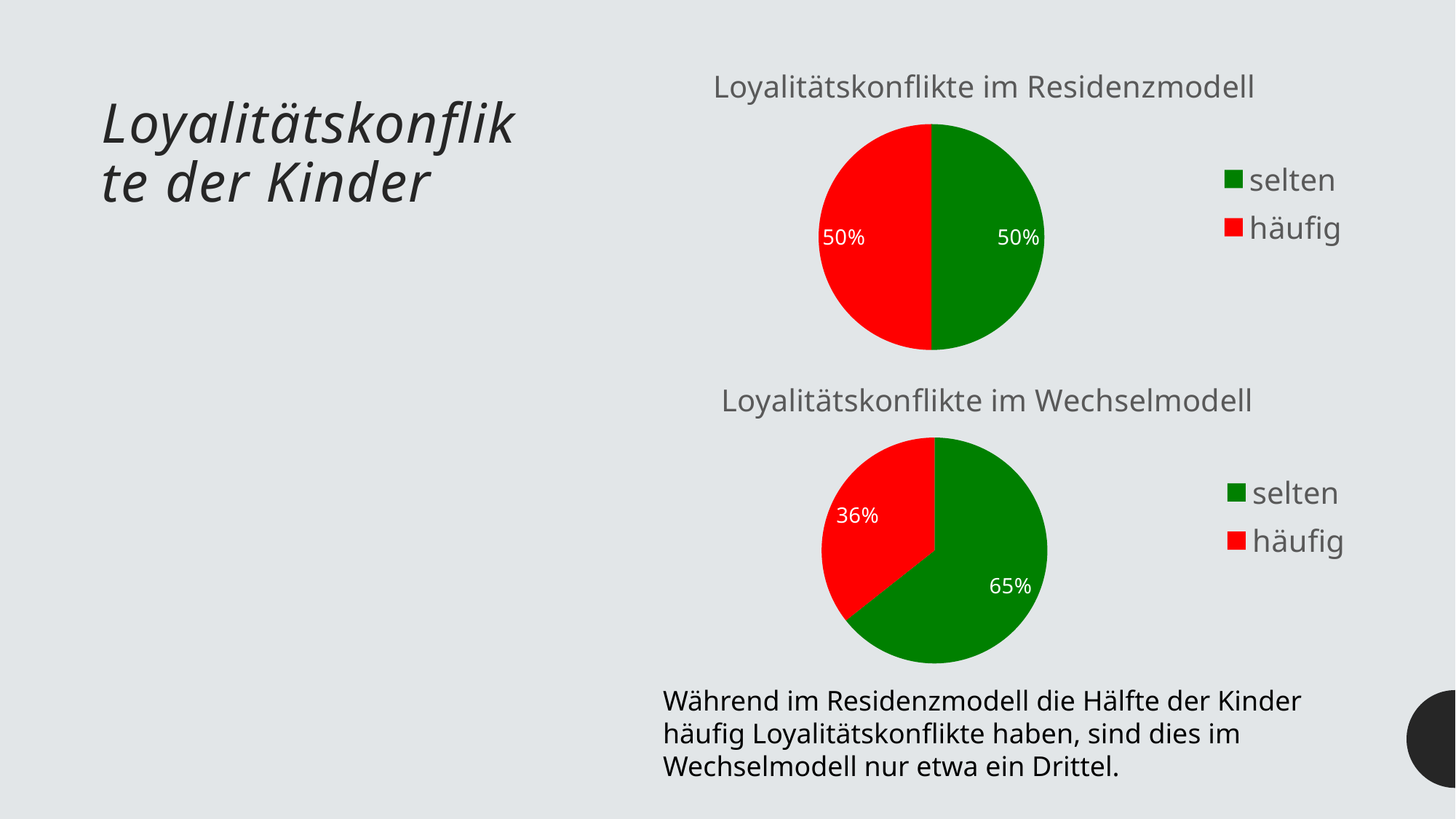
In the chart titled "Loyalitätskonflikte im Wechselmodell", by how many percentage points does "selten" exceed "häufig"? 29 percentage points In the chart titled "Loyalitätskonflikte im Residenzmodell", what percentage is shown for "häufig"? 50% What type of chart is the top chart, "Loyalitätskonflikte im Residenzmodell"? Pie chart How many entries does the legend of the chart titled "Loyalitätskonflikte im Residenzmodell" list? 2 In the chart titled "Loyalitätskonflikte im Residenzmodell", what percentage is shown for "selten"? 50% In the chart titled "Loyalitätskonflikte im Wechselmodell", which is larger, "selten" or "häufig"? selten In the chart titled "Loyalitätskonflikte im Wechselmodell", which category has the smallest slice? häufig In the chart titled "Loyalitätskonflikte im Wechselmodell", what colour represents "häufig"? Red In the chart titled "Loyalitätskonflikte im Wechselmodell", what percentage is shown for "häufig"? 36% In the chart titled "Loyalitätskonflikte im Wechselmodell", what percentage is shown for "selten"? 65% In the chart titled "Loyalitätskonflikte im Wechselmodell", which category has the largest slice? selten How many slices does the chart titled "Loyalitätskonflikte im Wechselmodell" have? 2